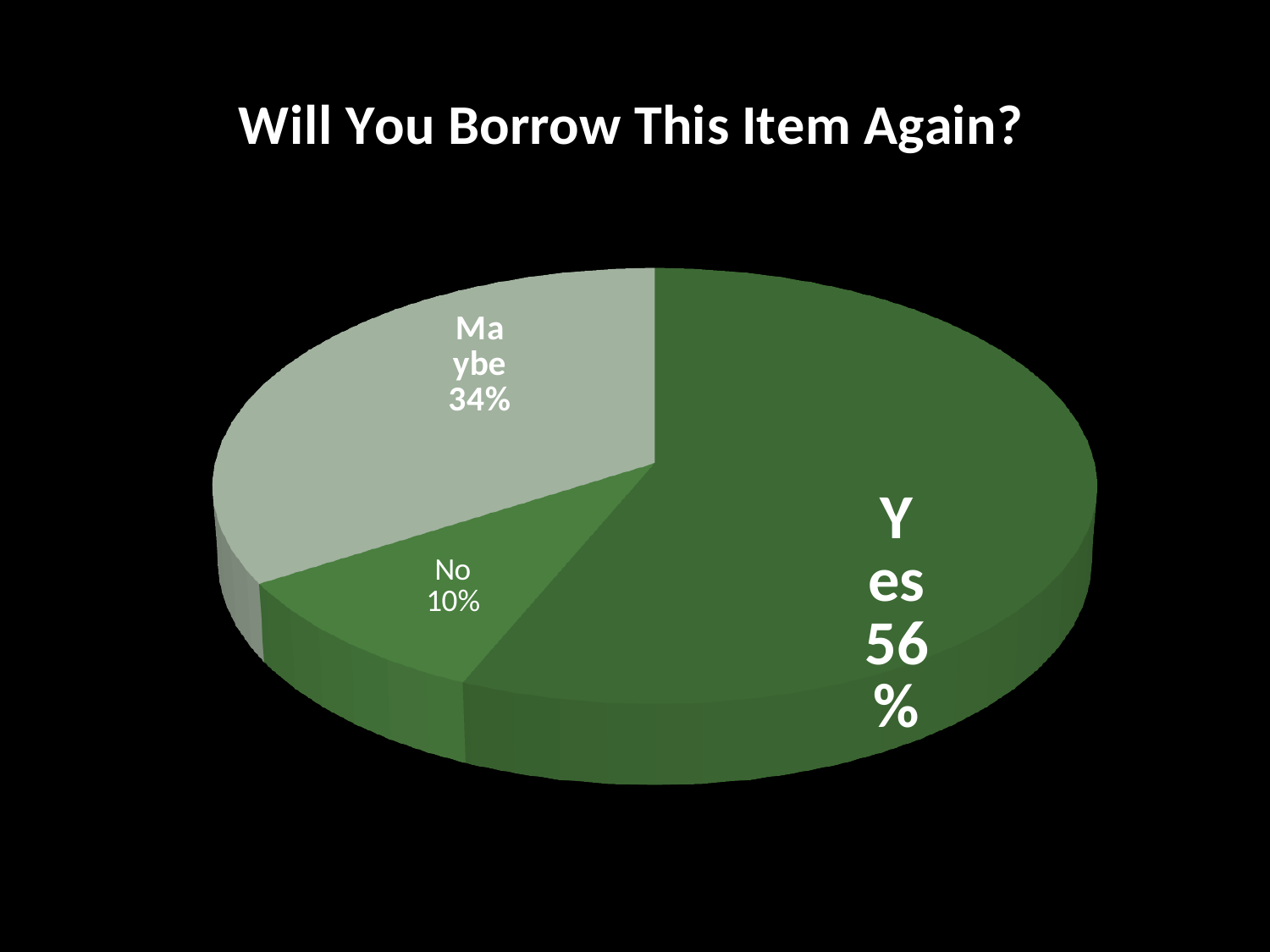
Which is larger, the share for Maybe or the share for No? Maybe What is the title of the chart? Will You Borrow This Item Again? What is the difference in percentage points between Maybe and No? 24 Which response has the largest share of the pie? Yes What percentage of respondents answered Maybe? 34% Which response has the smallest share of the pie? No What kind of chart is shown on the slide? pie chart What percentage of respondents answered No? 10% What share of the pie does the Yes slice represent? 56% What is the difference in percentage points between Yes and Maybe? 22 How many slices does the pie chart have? 3 What percentage of respondents answered Yes? 56%